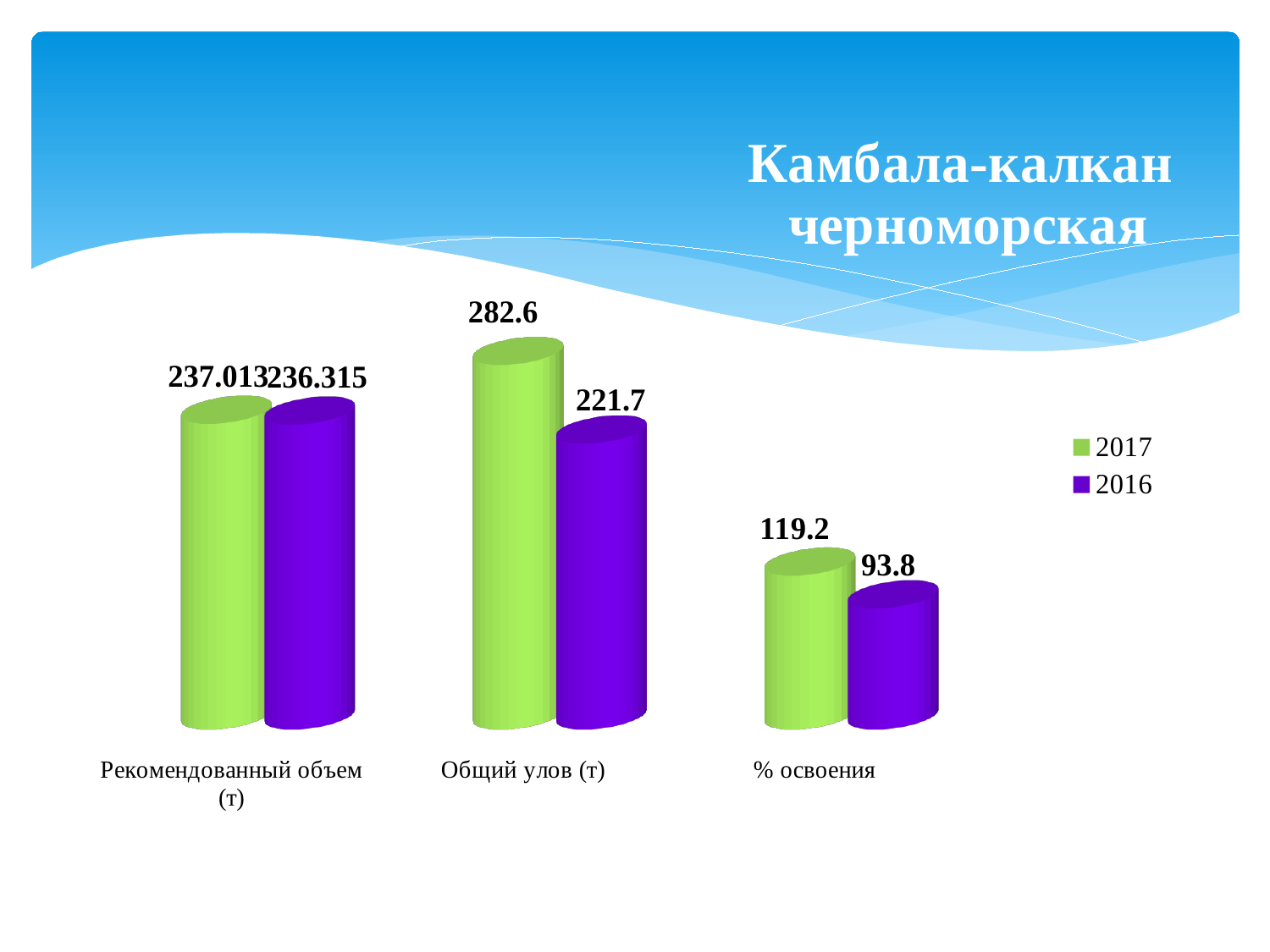
Which category has the highest value for the 2017 series? Общий улов (т) What is the value for 2016 in the "% освоения" category? 93.8 How many series does the legend list? 2 What is the value for 2016 in the "Рекомендованный объем (т)" category? 236.315 What is the value for 2017 in the "% освоения" category? 119.2 What is the value for 2016 in the "Общий улов (т)" category? 221.7 What is the title of the slide containing the chart? Камбала-калкан черноморская In the "% освоения" category, which series has the larger value, 2017 or 2016? 2017 What is the value for 2017 in the "Общий улов (т)" category? 282.6 What is the value for 2017 in the "Рекомендованный объем (т)" category? 237.013 Which category has the lowest value for the 2016 series? % освоения What is the difference between the 2017 and 2016 values in the "Общий улов (т)" category? 60.9